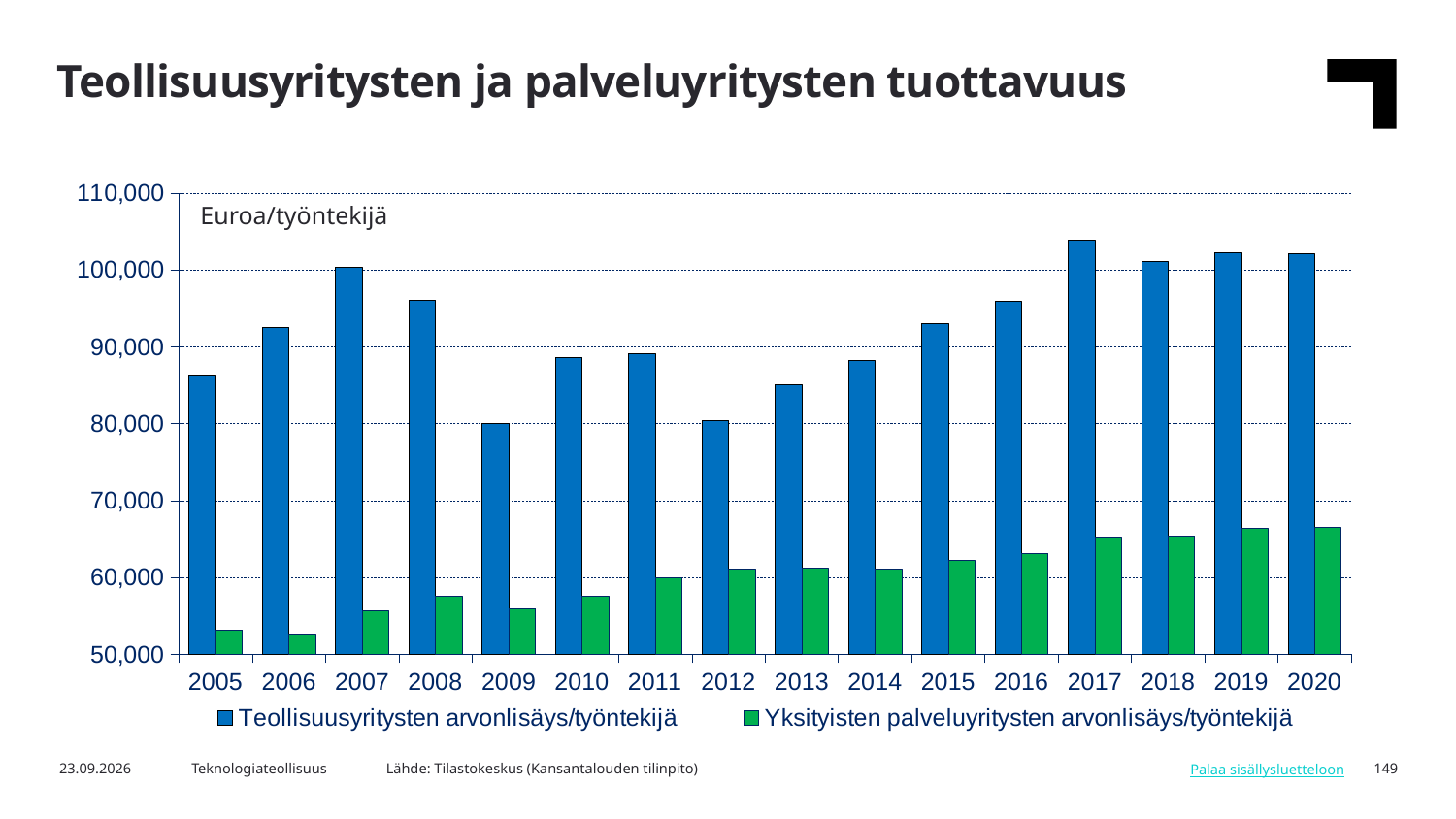
Which is larger: Yksityisten palveluyritysten arvonlisäys/työntekijä in 2005 or in 2020? 2020 What unit label is shown inside the chart area? Euroa/työntekijä How many years are shown on the x axis? 16 How many series does the legend list? 2 Is the value for Teollisuusyritysten arvonlisäys/työntekijä in 2017 greater or less than 100,000? greater In which year is Teollisuusyritysten arvonlisäys/työntekijä highest? 2017 Is the value for Teollisuusyritysten arvonlisäys/työntekijä in 2009 greater or less than 90,000? less What kind of chart is shown on the slide? bar chart Is the value for Yksityisten palveluyritysten arvonlisäys/työntekijä in 2005 greater or less than 60,000? less Which is larger: Teollisuusyritysten arvonlisäys/työntekijä in 2008 or in 2009? 2008 Does Yksityisten palveluyritysten arvonlisäys/työntekijä generally rise or fall from 2005 to 2020? rise